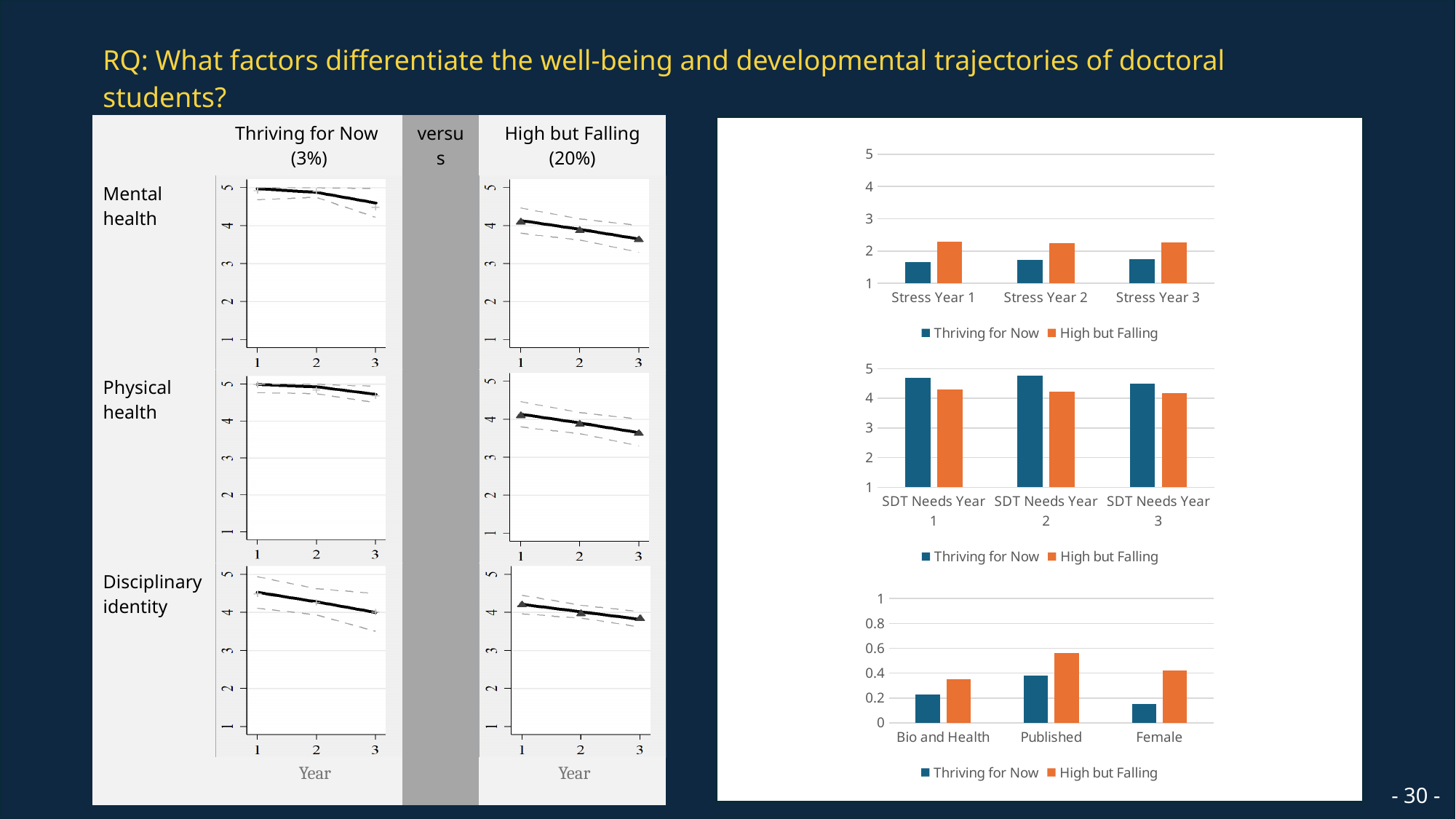
In the left panel, does the Mental health line for the High but Falling group rise or fall from Year 1 to Year 3? fall In the top-right bar chart (Stress Year 1 to Stress Year 3), how many series does the legend list? 2 In the top-right bar chart, is the High but Falling value for Stress Year 1 greater or less than 2? greater In the middle-right bar chart (SDT Needs), is the Thriving for Now value for SDT Needs Year 2 greater or less than 4? greater In the bottom-right bar chart, which category has the highest High but Falling value? Published In the top-right bar chart, which series has the higher value for Stress Year 1, Thriving for Now or High but Falling? High but Falling What kind of chart is the bottom-right chart showing Bio and Health, Published and Female? bar chart In the bottom-right bar chart, which category has the lowest Thriving for Now value? Female How many categories are shown on the x axis of the middle-right bar chart (SDT Needs)? 3 In the middle-right bar chart (SDT Needs), which series has the higher value for SDT Needs Year 1? Thriving for Now In the top-right bar chart, is the Thriving for Now value for Stress Year 2 greater or less than 2? less